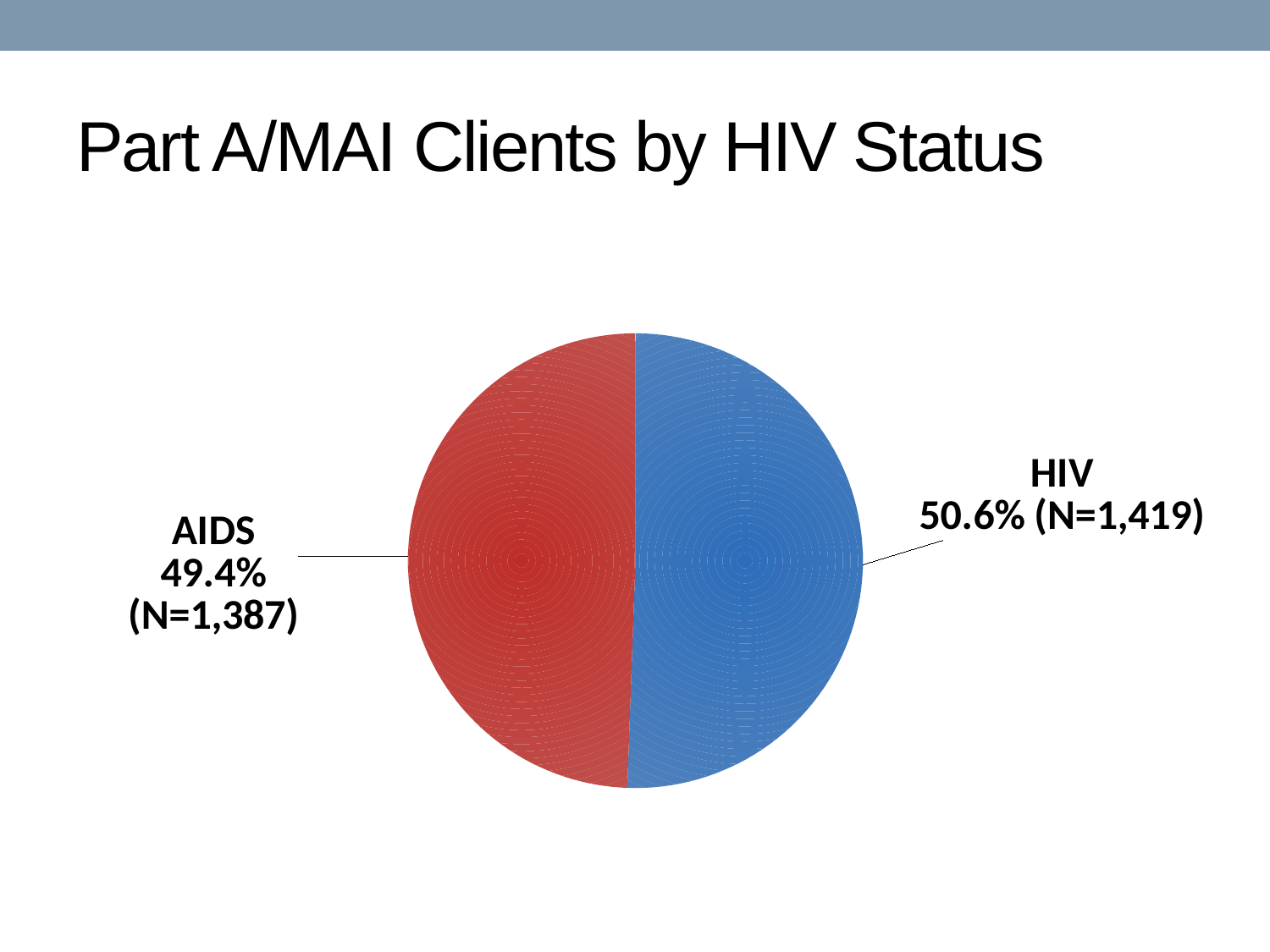
What kind of chart is shown on the slide? pie chart What is the title of the chart? Part A/MAI Clients by HIV Status Which HIV status category has the larger share of clients according to the printed labels? HIV Which HIV status category has the smaller share of clients according to the printed labels? AIDS How many more clients are in the HIV category than in the AIDS category? 32 What percentage of Part A/MAI clients have an HIV status of AIDS? 49.4% What percentage of Part A/MAI clients have an HIV status of HIV? 50.6% What is the number of clients (N) in the HIV slice? 1,419 How many slices does the pie chart have? 2 Which colour represents the AIDS slice in the pie chart? red What is the total number of clients across both slices of the pie chart? 2,806 What is the number of clients (N) in the AIDS slice? 1,387